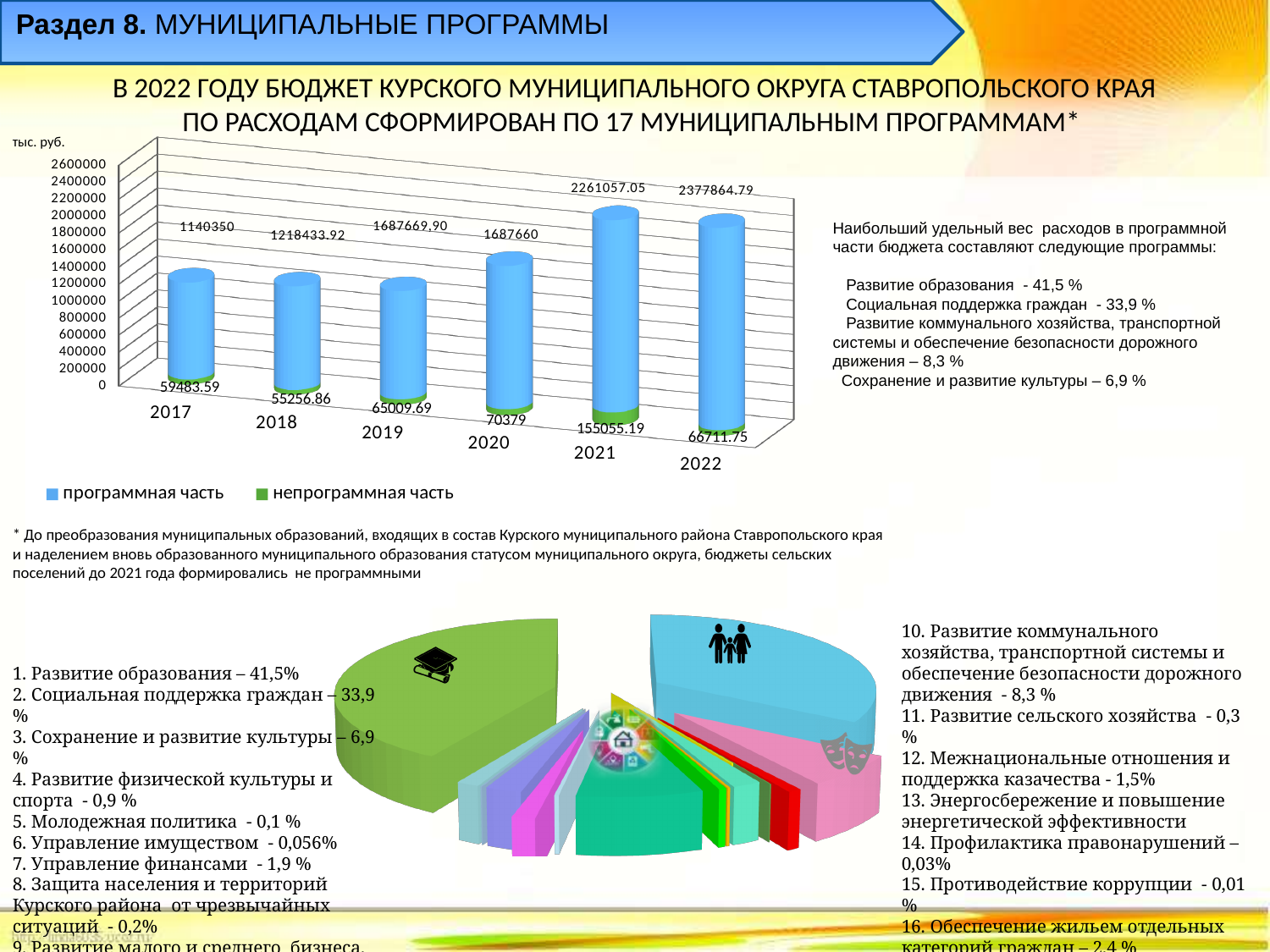
In the bar chart at the top of the slide, which year has the lowest value for программная часть? 2017 How many series does the legend of the bar chart at the top of the slide list? 2 In the bar chart at the top of the slide, what is the value of the непрограммная часть series for 2017? 59483.59 In the bar chart at the top of the slide, which year has the highest value for непрограммная часть? 2021 In the bar chart at the top of the slide, what is the value of the программная часть series for 2019? 1687669.90 In the bar chart at the top of the slide, what is the difference between the программная часть values for 2022 and 2021? 116807.74 In the bar chart at the top of the slide, which is larger: the непрограммная часть value for 2021 or for 2022? 2021 How many years are shown on the x axis of the bar chart at the top of the slide? 6 What kind of chart is shown at the bottom of the slide? Pie chart In the bar chart at the top of the slide, what is the value of the программная часть series for 2022? 2377864.79 In the bar chart at the top of the slide, does the программная часть series generally rise or fall from 2017 to 2022? Rise In the bar chart at the top of the slide, what is the total of the two series for 2022? 2444576.54